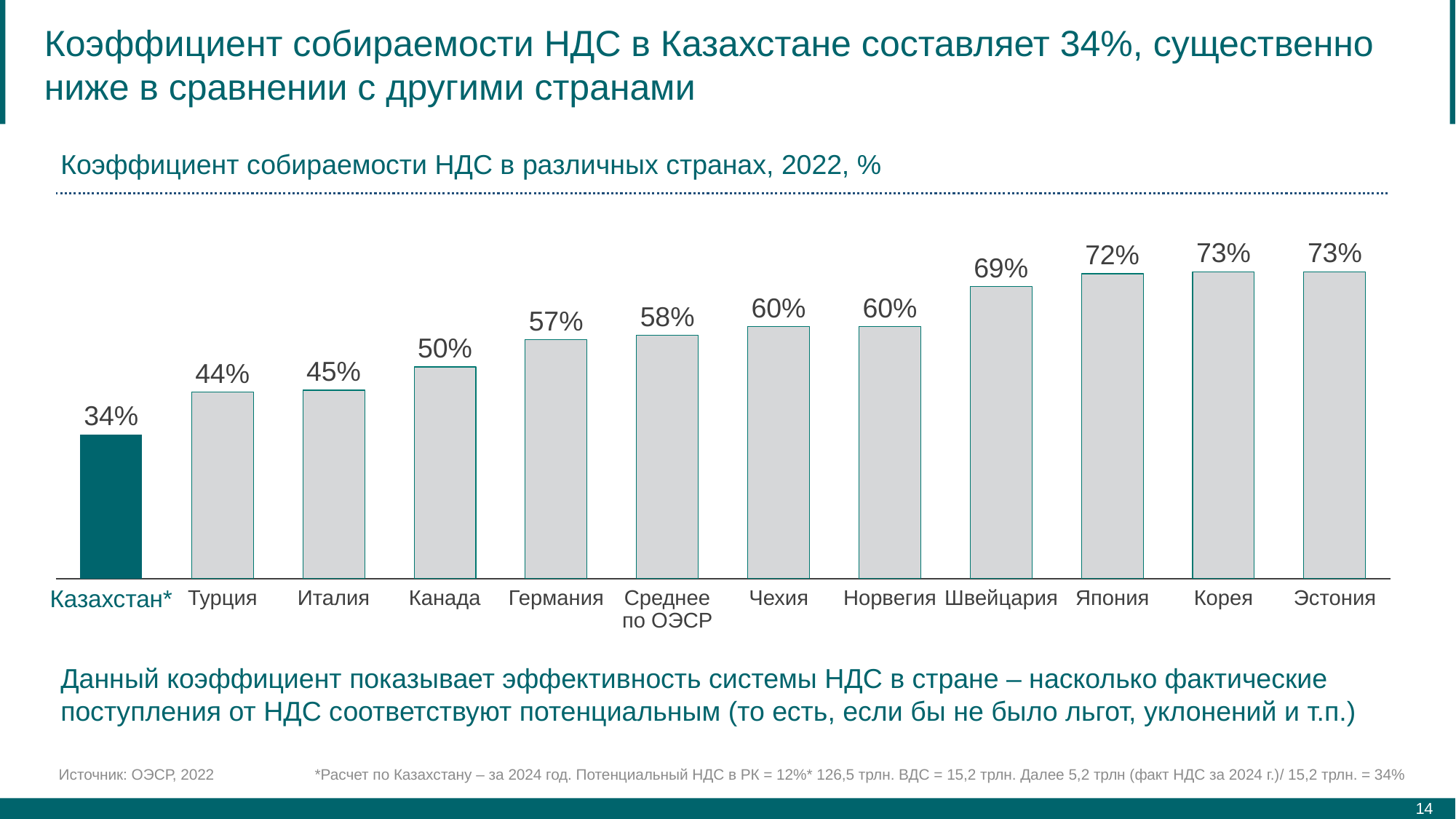
How many bars (categories) are shown on the chart? 12 What value is shown for Швейцария? 69% What type of chart is shown on the slide? Bar chart What is the difference between the values for Среднее по ОЭСР and Казахстан*? 24 percentage points Do the values rise or fall from left to right across the chart? Rise Which category has the lowest value on the chart? Казахстан* Which has a higher value, Япония or Швейцария? Япония What value is shown for Среднее по ОЭСР? 58% What is the difference between the values for Эстония and Казахстан*? 39 percentage points Which bar is coloured differently (dark teal) from the other grey bars? Казахстан* What is the VAT collection coefficient for Казахстан* on the chart? 34% What value is shown for Германия? 57%